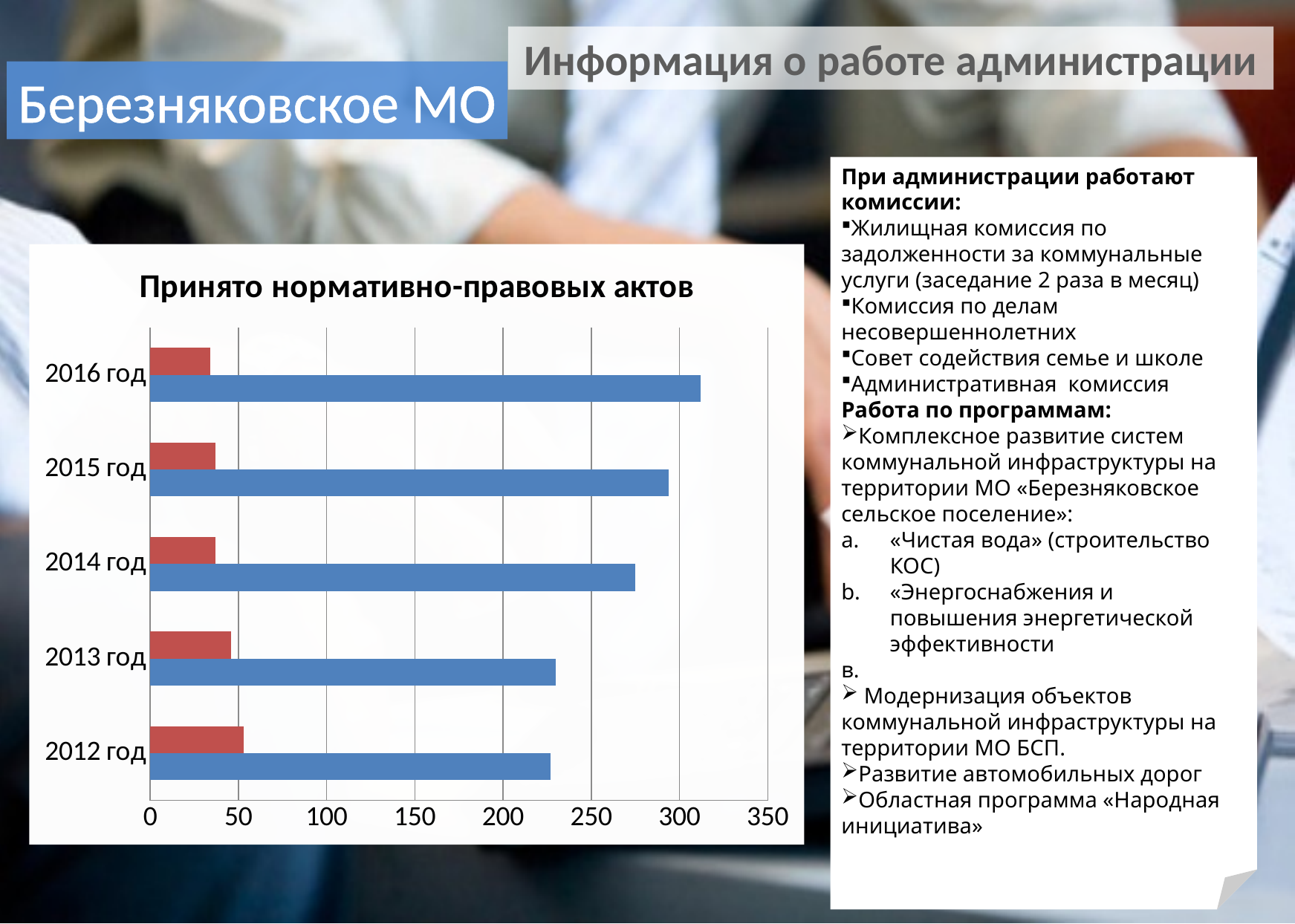
Which year has the longest red bar? 2012 год How many years (categories) are shown on the chart? 5 Which year has the longest blue bar? 2016 год Is the blue bar for 2016 год greater or less than 300? greater Is the red bar for 2016 год greater or less than 50? less What is the title of the chart? Принято нормативно-правовых актов What is the maximum value shown on the horizontal axis? 350 Which is larger, the blue bar for 2016 год or the blue bar for 2014 год? 2016 год Do the blue bars rise or fall from 2012 год to 2016 год? rise What kind of chart is shown on the slide? bar chart Is the blue bar for 2013 год greater or less than 250? less